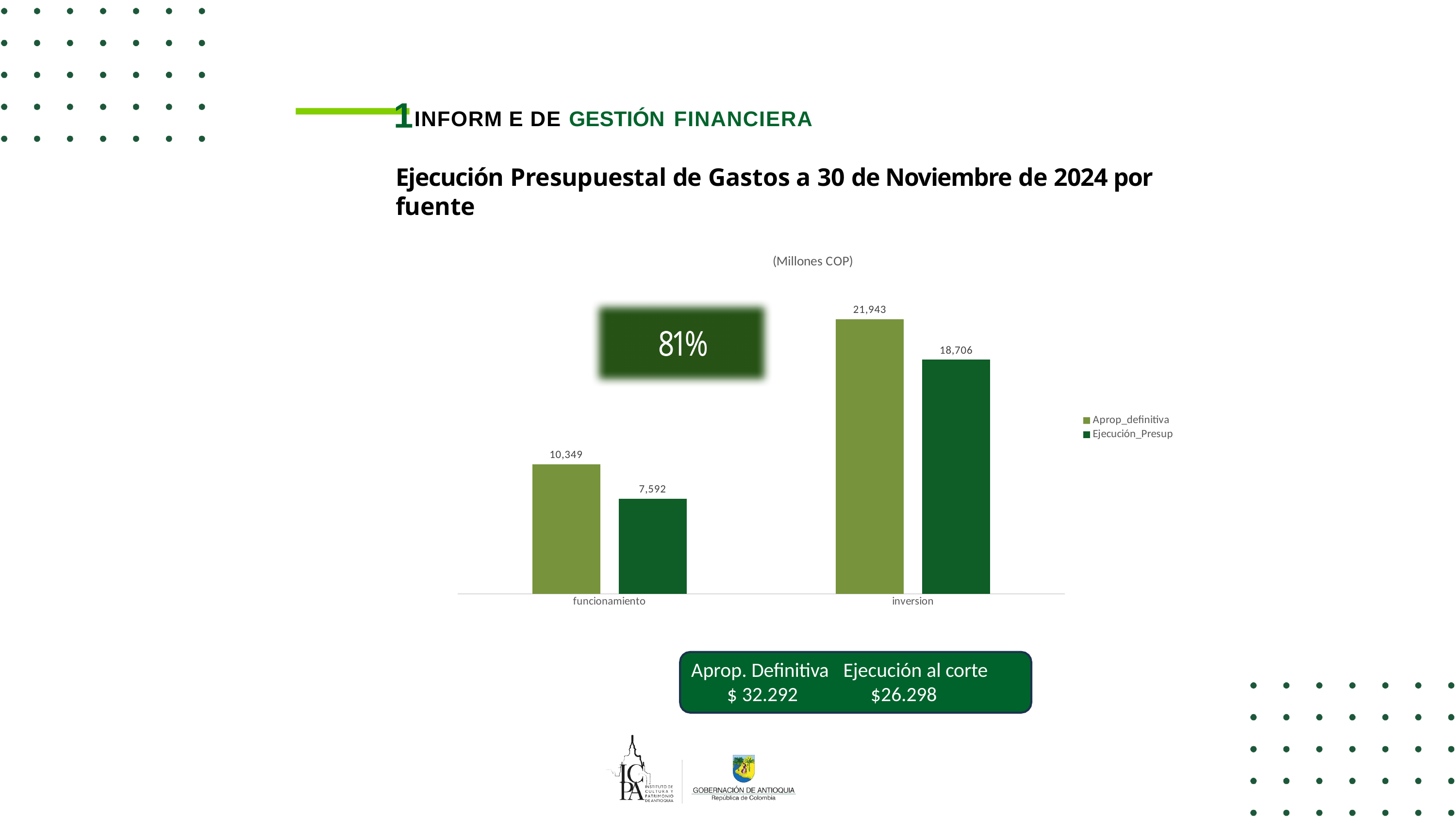
What is the difference between Aprop_definitiva and Ejecución_Presup for funcionamiento? 2,757 Which category has the lowest Ejecución_Presup value? funcionamiento Which category has the highest Aprop_definitiva value? inversion What is the Ejecución_Presup value for inversion? 18,706 What is the difference between Aprop_definitiva and Ejecución_Presup for inversion? 3,237 What is the Aprop_definitiva value for funcionamiento? 10,349 Which is larger: Ejecución_Presup for inversion or Aprop_definitiva for funcionamiento? Ejecución_Presup for inversion What is the Aprop_definitiva value for inversion? 21,943 How many series does the legend list? 2 How many categories are shown on the x axis? 2 What is the Ejecución_Presup value for funcionamiento? 7,592 What kind of chart is shown on the slide? bar chart